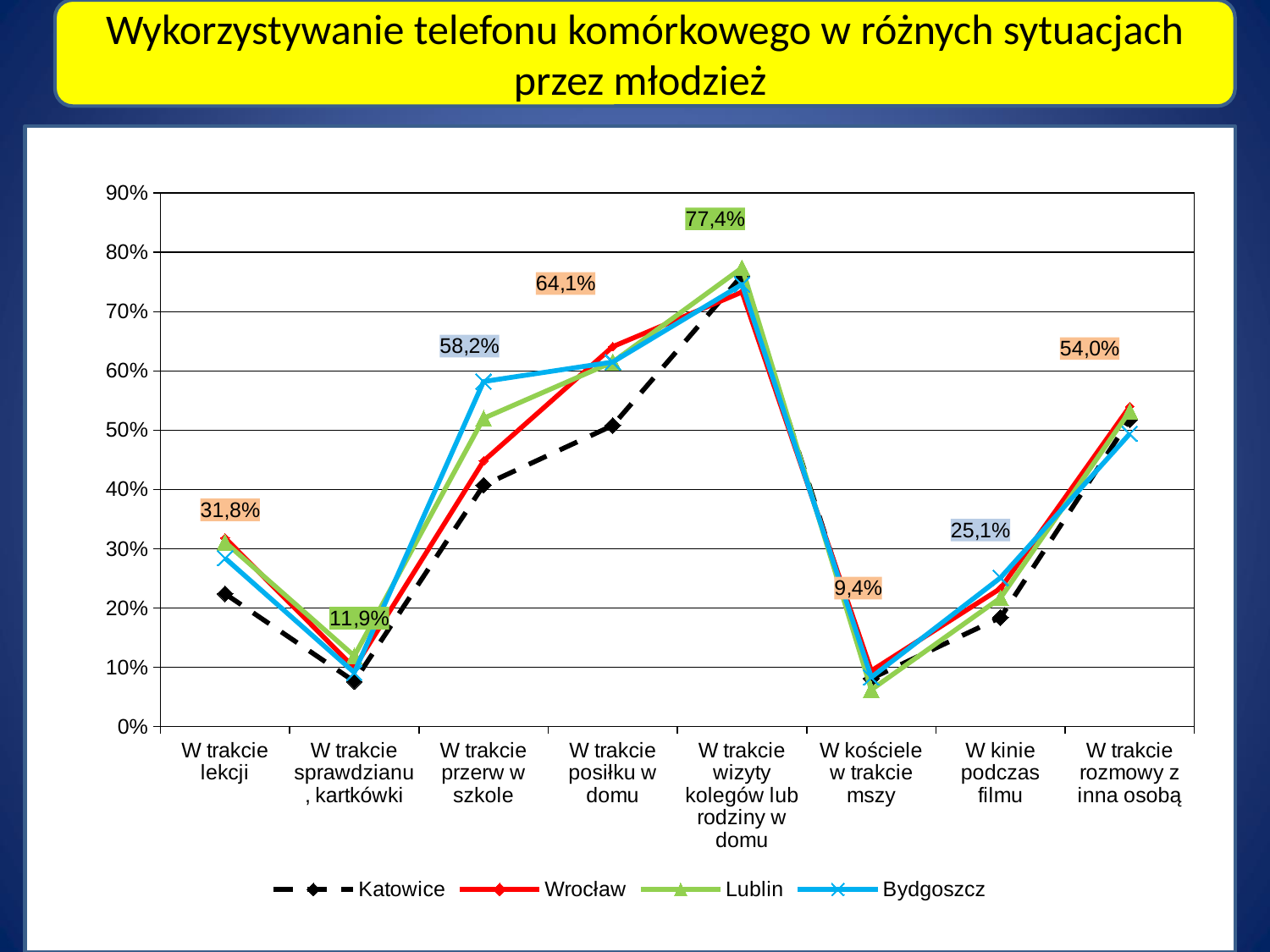
What is the data label shown for the category 'W trakcie rozmowy z inna osobą'? 54,0% How many situation categories are shown on the x axis? 8 Which series is drawn as a dashed black line? Katowice What is the data label shown for the category 'W trakcie wizyty kolegów lub rodziny w domu'? 77,4% What is the data label shown for the category 'W kościele w trakcie mszy'? 9,4% What is the difference between the labelled values 77,4% and 9,4%? 68,0 percentage points How many series does the legend list? 4 What is the data label shown for the category 'W trakcie przerw w szkole'? 58,2% Is the value for Katowice at 'W trakcie lekcji' greater or less than 30%? less What kind of chart is shown on the slide? line chart At 'W trakcie przerw w szkole', which is larger: the value for Bydgoszcz or the value for Katowice? Bydgoszcz Which category has the highest values across all cities? W trakcie wizyty kolegów lub rodziny w domu